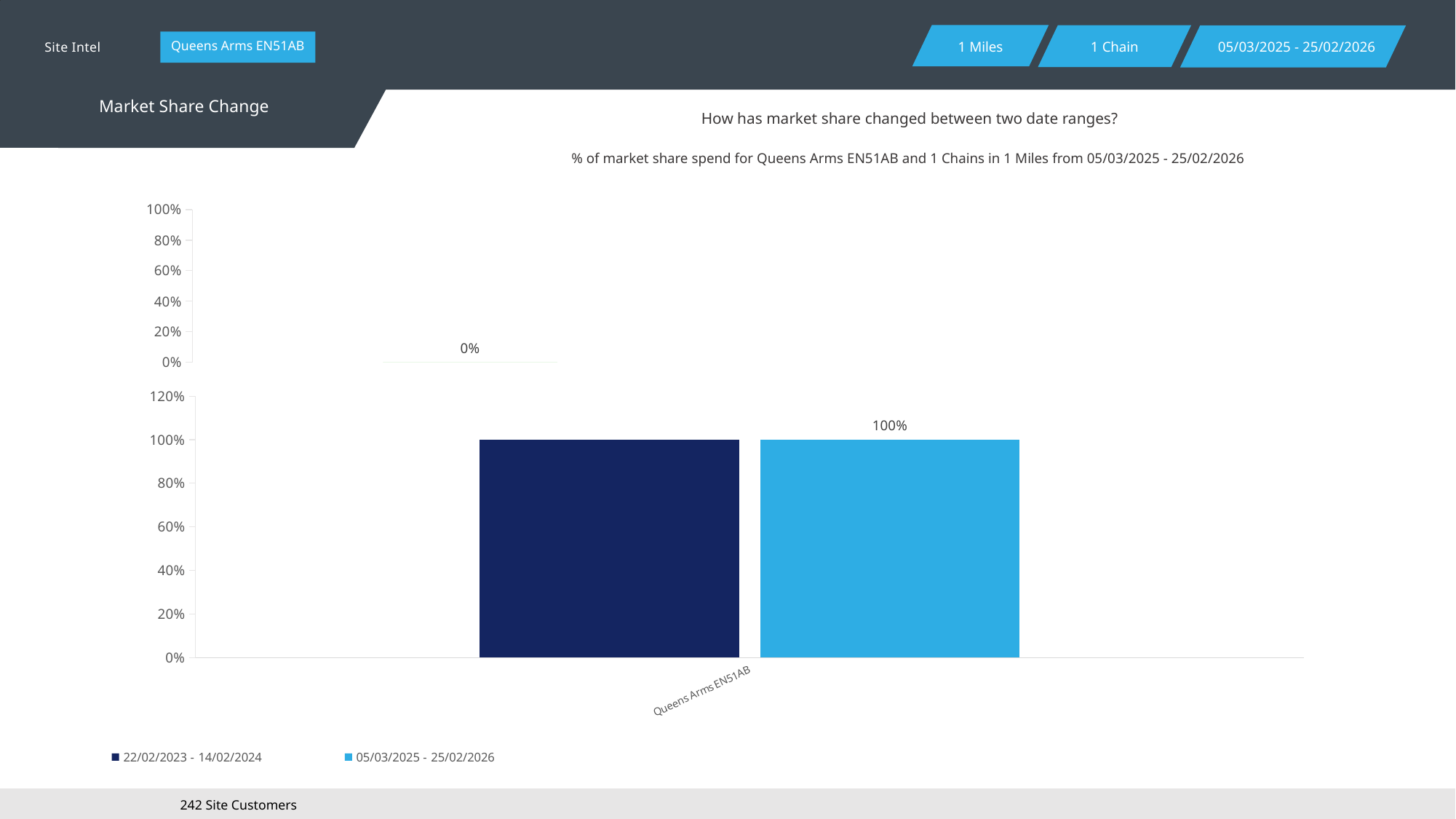
In the bottom chart, what is the value for Queens Arms EN51AB in the 05/03/2025 - 25/02/2026 series? 100% In the bottom chart, how many series does the legend list? 2 In the bottom chart, how many categories are shown on the x axis? 1 What is the highest tick value on the y axis of the bottom chart? 120% In the bottom chart, is the value for Queens Arms EN51AB in the 05/03/2025 - 25/02/2026 series greater or less than 120%? less In the bottom chart, what is the difference between the 05/03/2025 - 25/02/2026 value and the 22/02/2023 - 14/02/2024 value for Queens Arms EN51AB? 0% In the bottom chart, is the value for Queens Arms EN51AB in the 22/02/2023 - 14/02/2024 series greater or less than 80%? greater What is the highest tick value on the y axis of the top chart? 100% In the bottom chart, what is the value for Queens Arms EN51AB in the 22/02/2023 - 14/02/2024 series? 100% What kind of chart is the bottom chart? bar chart In the top chart, what value is printed as the data label? 0% In the bottom chart, which legend entry is shown in dark navy? 22/02/2023 - 14/02/2024